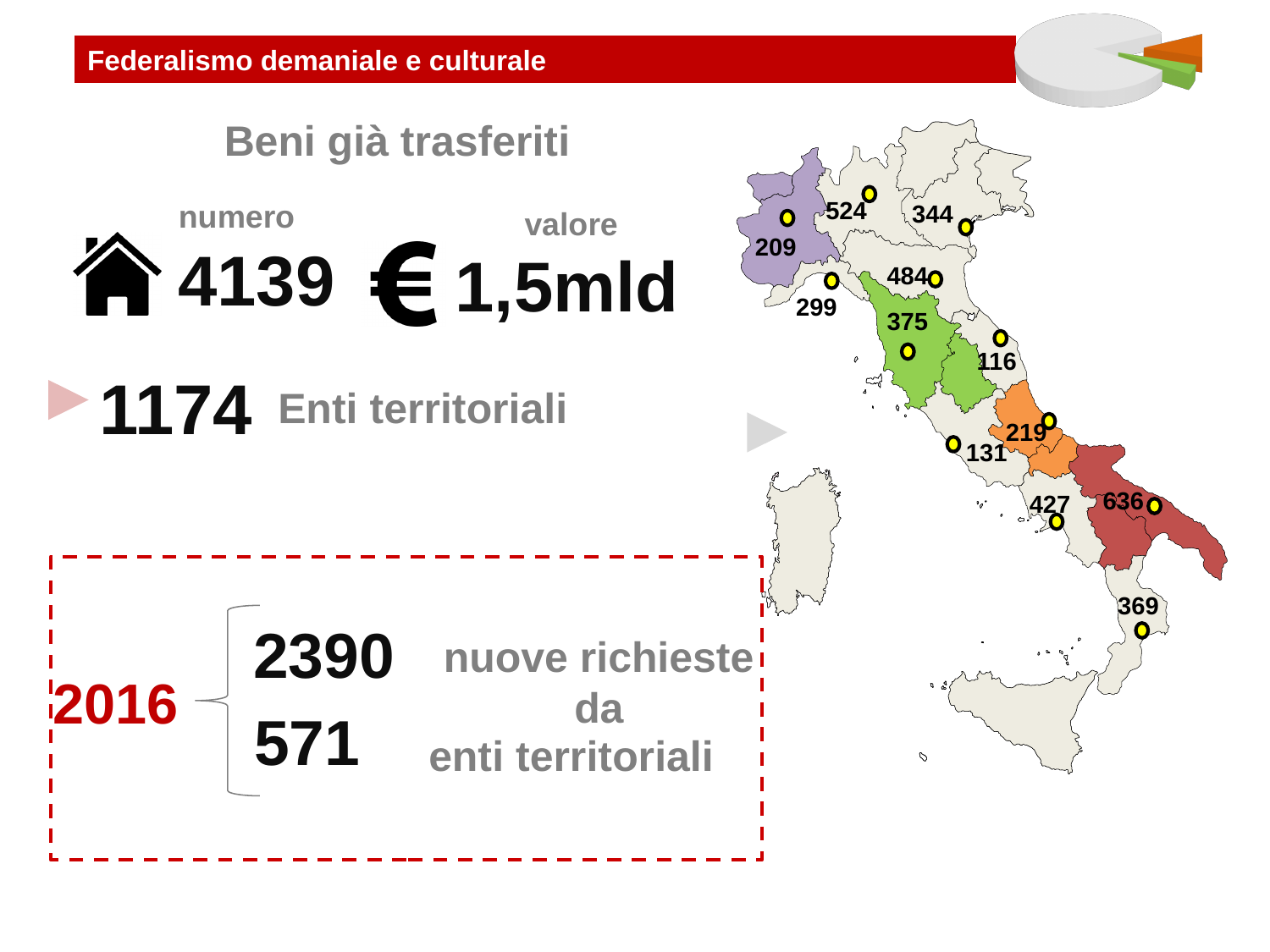
On the map of Italy, what is the highest value printed next to a marker? 636 On the map of Italy, which is larger: the value 524 in the north-west or the value 344 in the north-east? 524 How many numbered markers are shown on the map of Italy? 12 What kind of visual is used on the right side of the slide to show the values by region? A map of Italy On the map of Italy, what is the lowest value printed next to a marker? 116 On the map of Italy, what is the difference between the highest value (636) and the lowest value (116)? 520